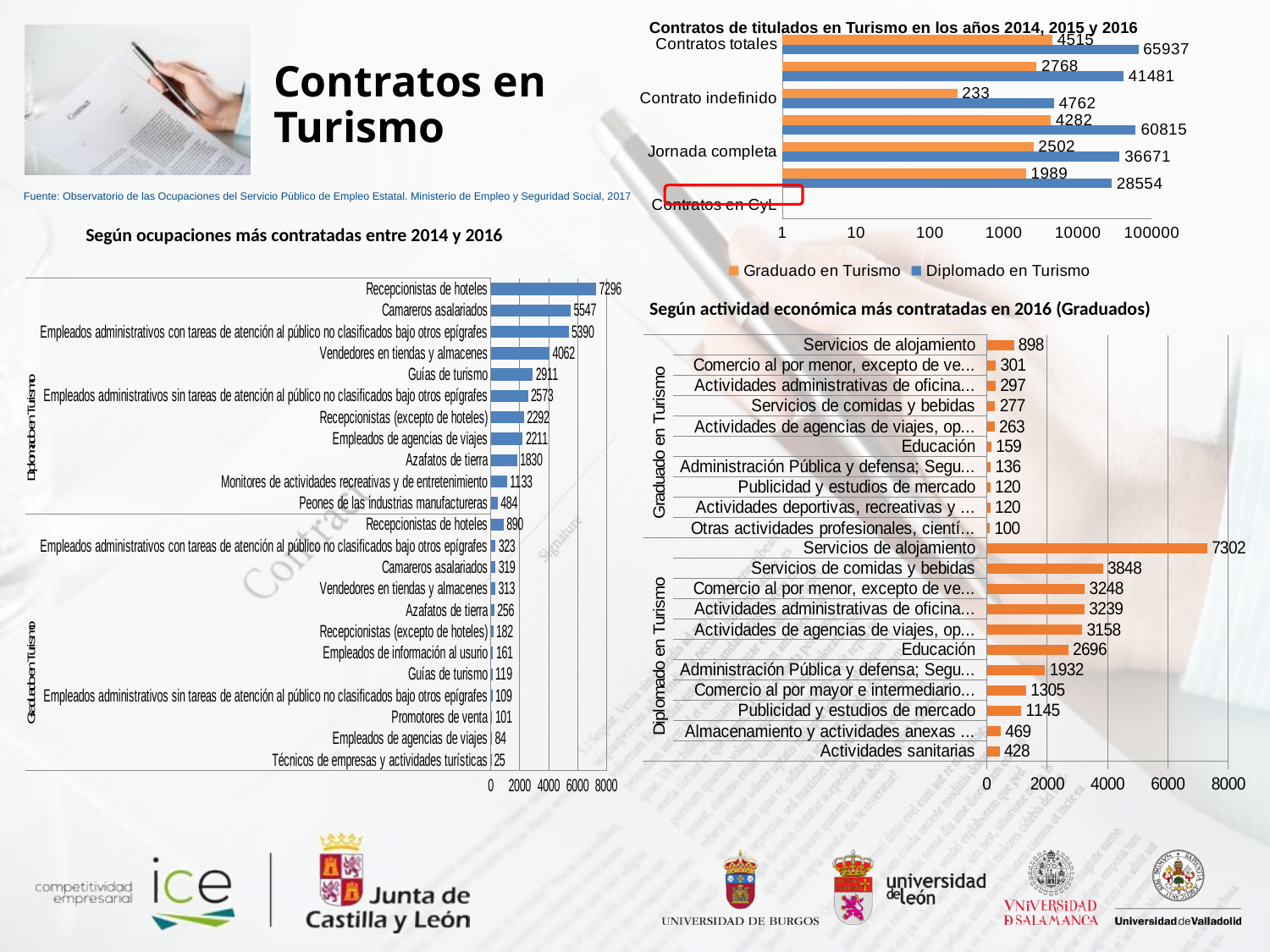
In the chart 'Según actividad económica más contratadas en 2016 (Graduados)', what is the difference between Almacenamiento y actividades anexas and Actividades sanitarias in the Diplomado en Turismo group? 41 In the chart 'Según actividad económica más contratadas en 2016 (Graduados)', which activity has the highest value in the Graduado en Turismo group? Servicios de alojamiento In the chart 'Según actividad económica más contratadas en 2016 (Graduados)', what is the value for Servicios de alojamiento in the Diplomado en Turismo group? 7302 In the chart 'Según actividad económica más contratadas en 2016 (Graduados)', which is larger in the Diplomado en Turismo group: Servicios de comidas y bebidas or Educación? Servicios de comidas y bebidas In the chart 'Contratos de titulados en Turismo en los años 2014, 2015 y 2016', what is the value of Contratos totales for Diplomado en Turismo? 65937 In the chart 'Según ocupaciones más contratadas entre 2014 y 2016', what is the difference between Camareros asalariados and Vendedores en tiendas y almacenes in the Diplomado en Turismo group? 1485 In the chart 'Según actividad económica más contratadas en 2016 (Graduados)', what is the value for Educación in the Graduado en Turismo group? 159 What kind of chart is 'Contratos de titulados en Turismo en los años 2014, 2015 y 2016'? Bar chart In the chart 'Según ocupaciones más contratadas entre 2014 y 2016', what is the value for Guías de turismo in the Graduado en Turismo group? 119 In the chart 'Según ocupaciones más contratadas entre 2014 y 2016', what is the value for Recepcionistas de hoteles in the Diplomado en Turismo group? 7296 How many series does the legend of the chart 'Contratos de titulados en Turismo en los años 2014, 2015 y 2016' list? 2 In the chart 'Según ocupaciones más contratadas entre 2014 y 2016', which occupation has the lowest value in the Graduado en Turismo group? Técnicos de empresas y actividades turísticas